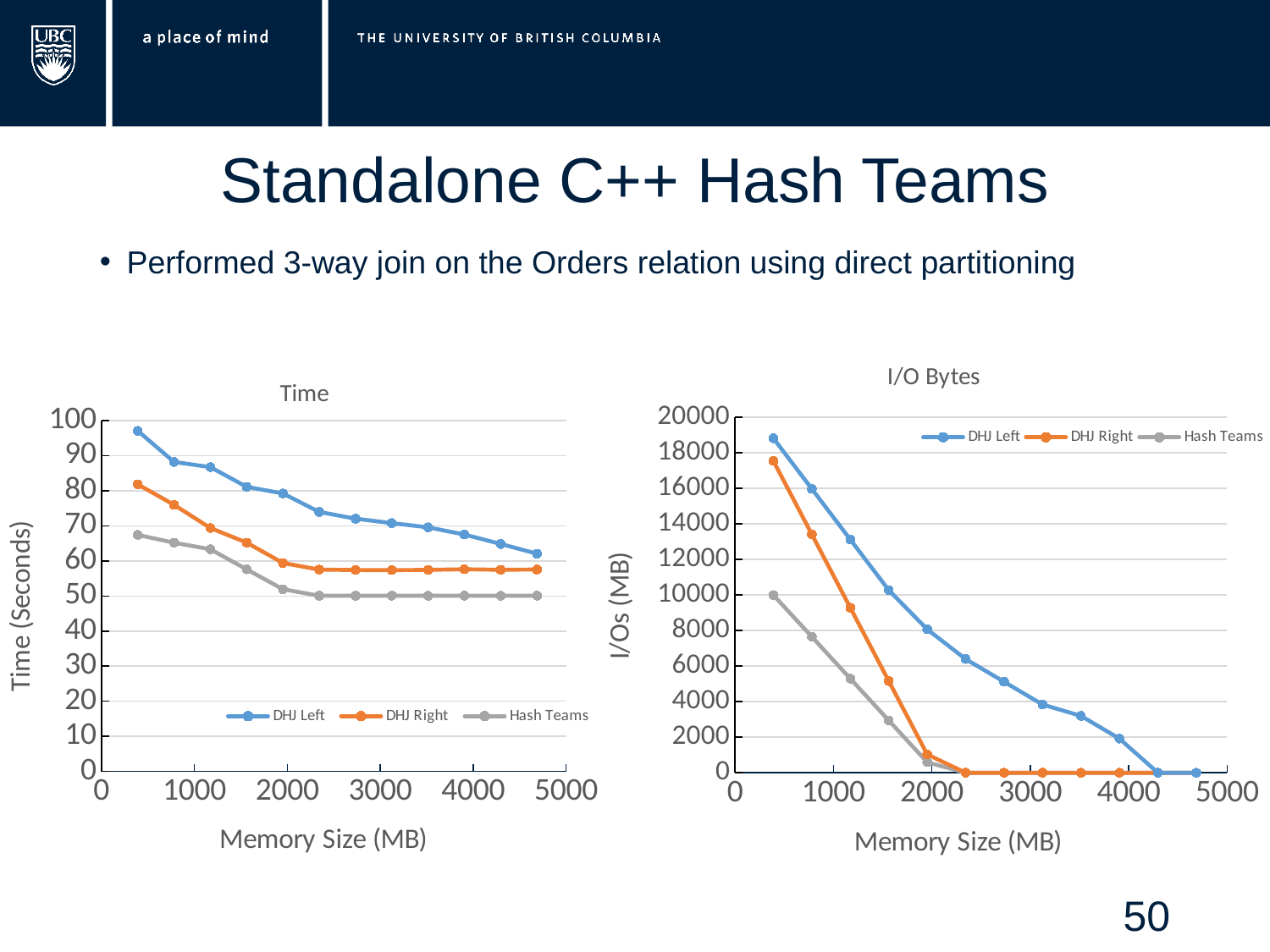
In the I/O Bytes chart, is the DHJ Left value at the smallest memory size greater or less than 18000? greater In the Time chart, do the times rise or fall as memory size increases? fall In the Time chart, which series has the lowest time across the memory sizes? Hash Teams In the Time chart, is the DHJ Right value at the largest memory size greater or less than 60? less How many series does the legend of the I/O Bytes chart list? 3 What is the y-axis title of the I/O Bytes chart? I/Os (MB) In the Time chart, which series has the highest time at the smallest memory size? DHJ Left What kind of chart is the Time chart on the left? line chart In the Time chart, is the DHJ Left value at the smallest memory size greater or less than 90? greater In the I/O Bytes chart, which series is larger at 3000 MB, DHJ Left or Hash Teams? DHJ Left In the I/O Bytes chart, which series has the highest I/Os at 1000 MB of memory? DHJ Left